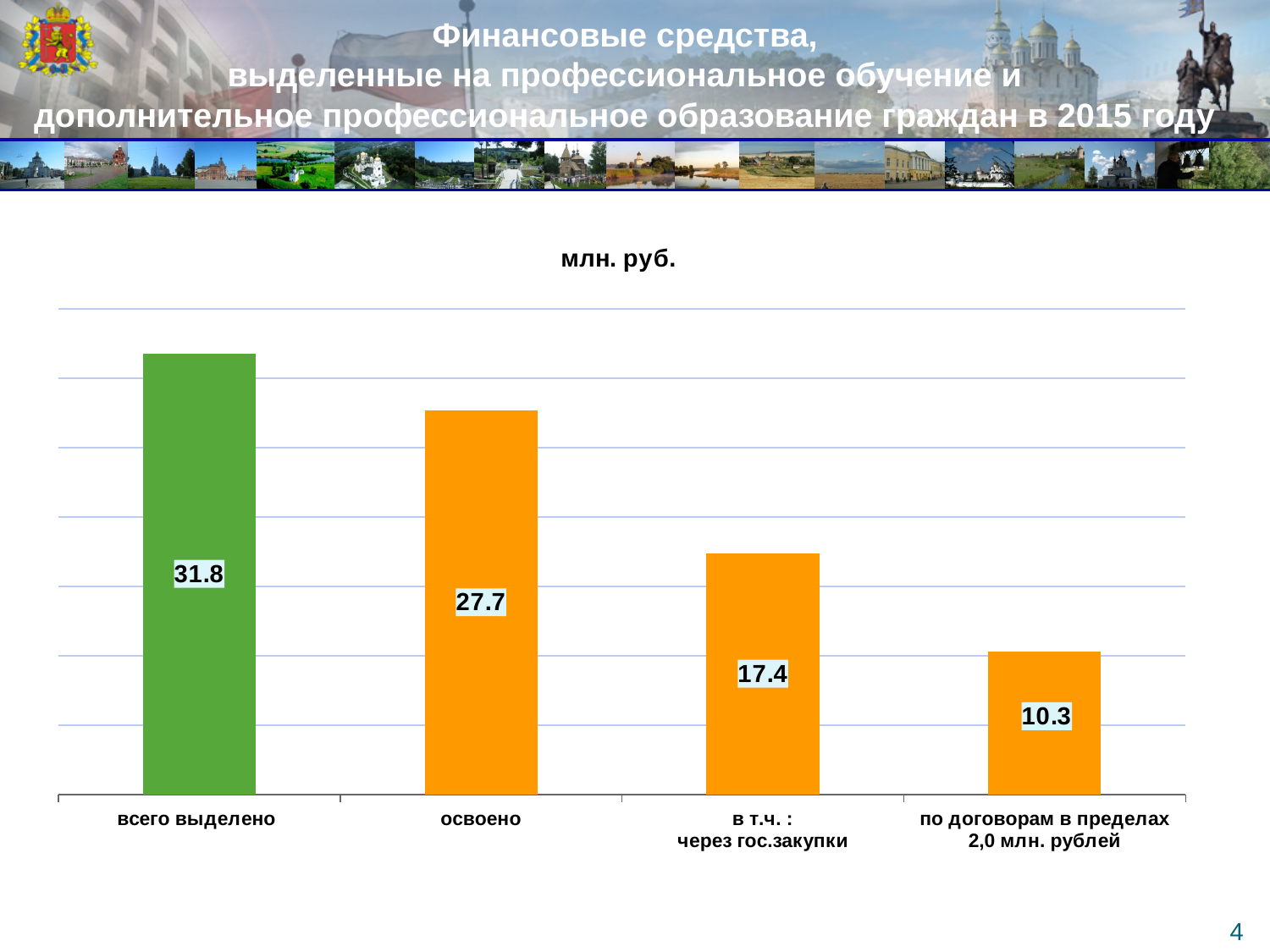
What is the value for "в т.ч.: через гос.закупки"? 17.4 What is the value for "всего выделено"? 31.8 What is the difference between "всего выделено" and "освоено"? 4.1 What kind of chart is shown on the slide? bar chart Which is larger: "освоено" or "через гос.закупки"? освоено Which category has the lowest value? по договорам в пределах 2,0 млн. рублей What is the value for "освоено"? 27.7 How many categories are shown in the chart? 4 Which category has the highest value? всего выделено What is the value for "по договорам в пределах 2,0 млн. рублей"? 10.3 What unit is given in the chart title? млн. руб. What is the difference between "через гос.закупки" and "по договорам в пределах 2,0 млн. рублей"? 7.1